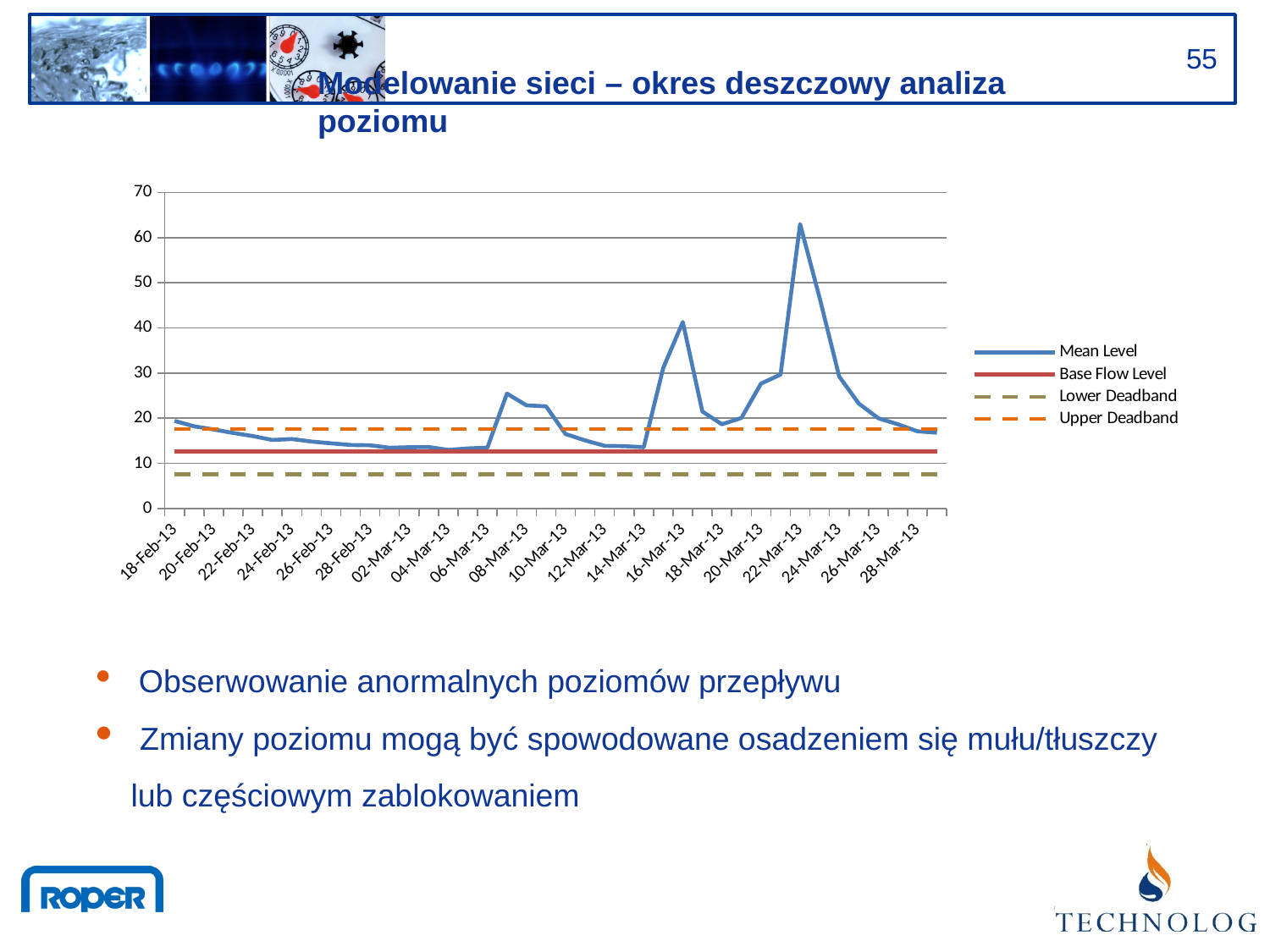
Which is higher, the Upper Deadband or the Base Flow Level? Upper Deadband On which date does the Mean Level reach its highest value? 22-Mar-13 Is the Mean Level on 16-Mar-13 greater or less than 30? greater Is the Lower Deadband value greater or less than 10? less What kind of chart is shown on the slide? line chart Which series is drawn as a solid red line? Base Flow Level How many series does the chart's legend list? 4 Between 18-Feb-13 and 06-Mar-13, does the Mean Level generally rise or fall? fall Is the Base Flow Level value greater or less than 10? greater What are the series names listed in the chart's legend? Mean Level, Base Flow Level, Lower Deadband, Upper Deadband